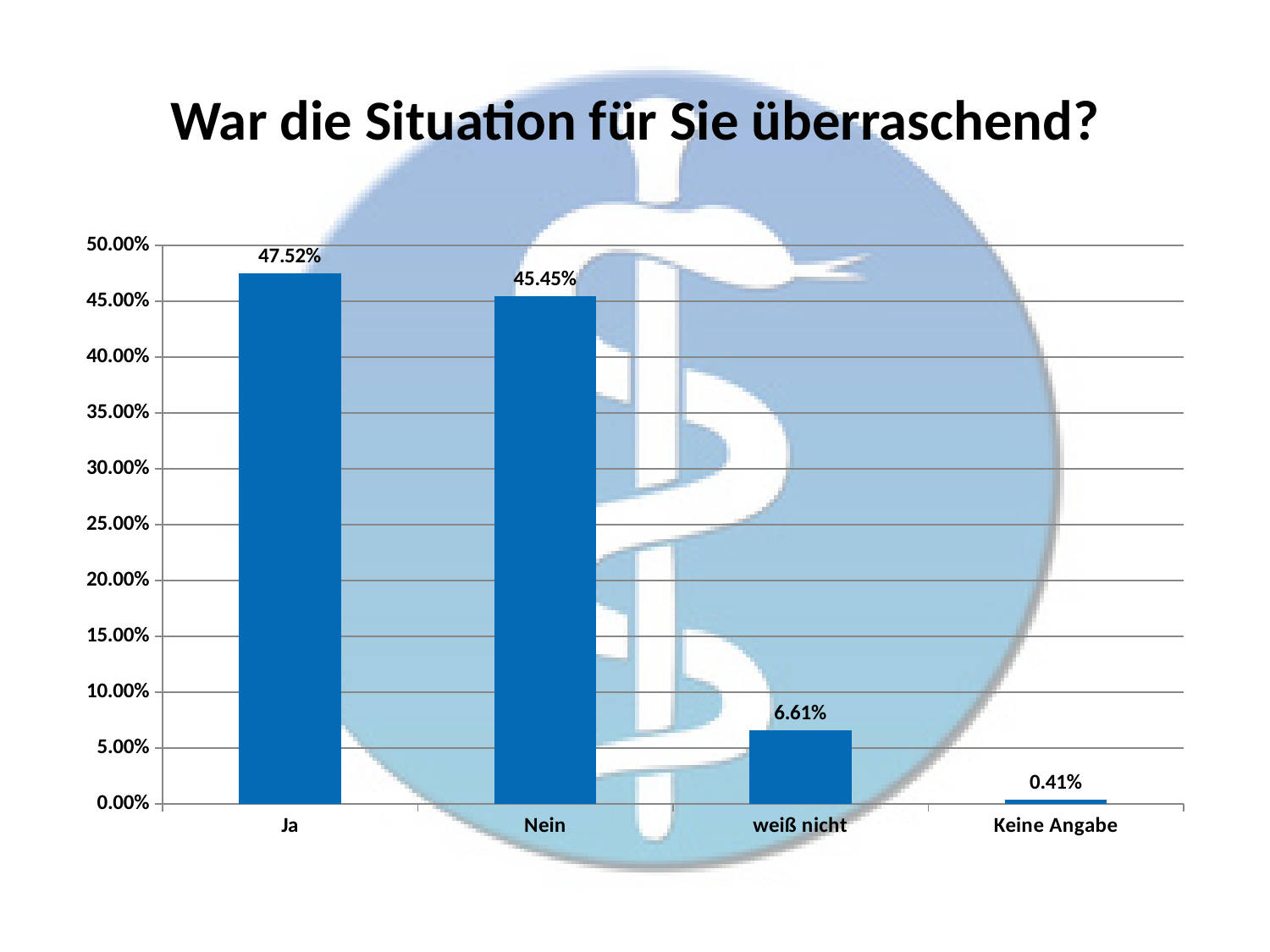
Which category has the highest value? Ja Which is larger, the value for "weiß nicht" or the value for "Keine Angabe"? weiß nicht What is the value for "Nein"? 45.45% What is the difference between the values for "Ja" and "Nein"? 2.07% Is the value for "weiß nicht" greater or less than 10.00%? less What is the title of the chart? War die Situation für Sie überraschend? How many categories are shown on the x axis? 4 What is the value for "Keine Angabe"? 0.41% Which category has the lowest value? Keine Angabe What is the value for "Ja"? 47.52% What is the value for "weiß nicht"? 6.61% What kind of chart is shown on the slide? bar chart